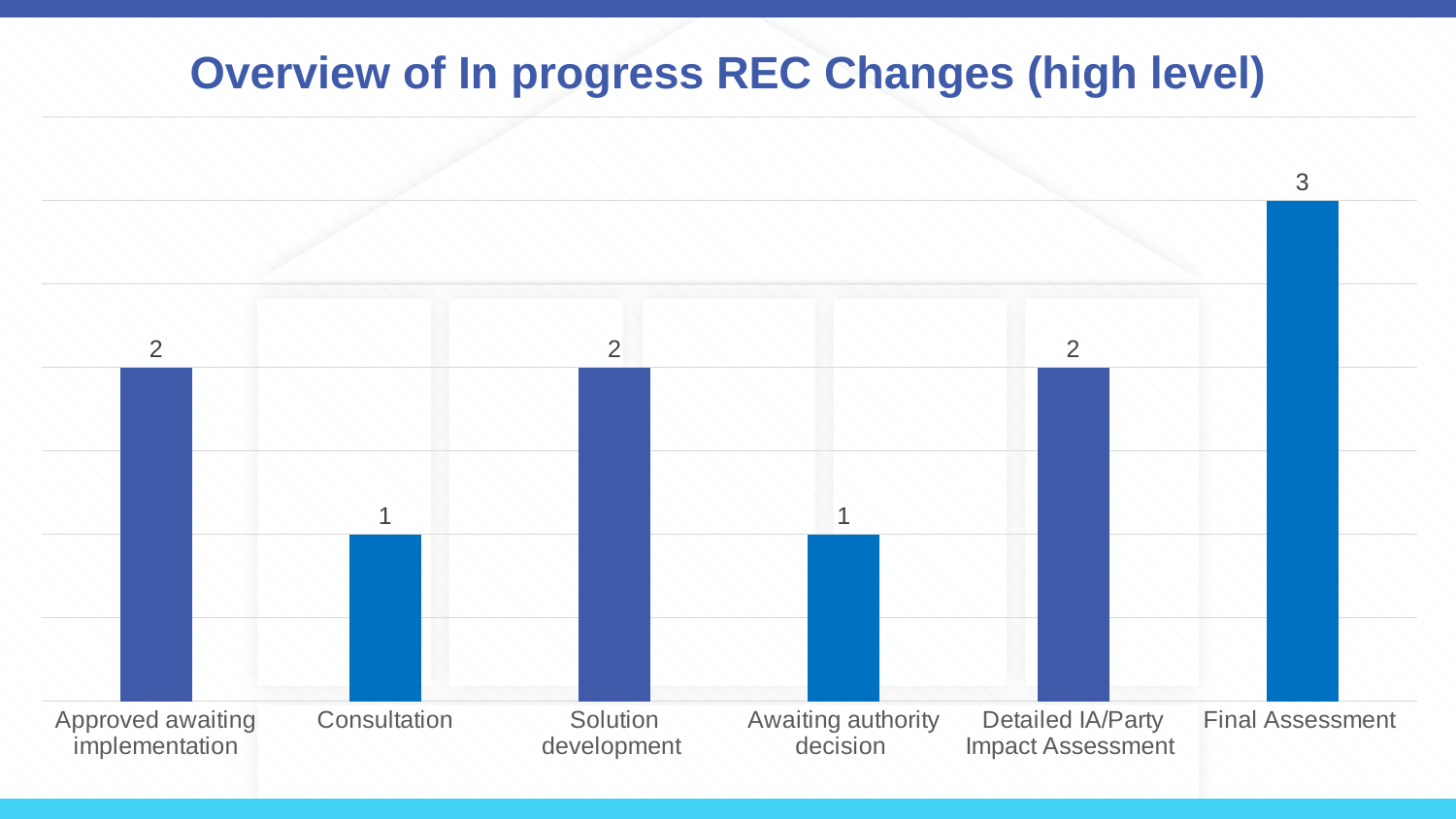
Which is larger, the value for Approved awaiting implementation or the value for Consultation? Approved awaiting implementation How many categories are shown on the x axis? 6 What is the value for Detailed IA/Party Impact Assessment? 2 What is the difference between the values for Final Assessment and Consultation? 2 Which category has the highest value? Final Assessment What is the title of the chart? Overview of In progress REC Changes (high level) What kind of chart is shown on the slide? Bar chart What is the value for Consultation? 1 What is the difference between the values for Solution development and Awaiting authority decision? 1 What is the value for Awaiting authority decision? 1 What is the value for Final Assessment? 3 How many categories have a value of 2? 3